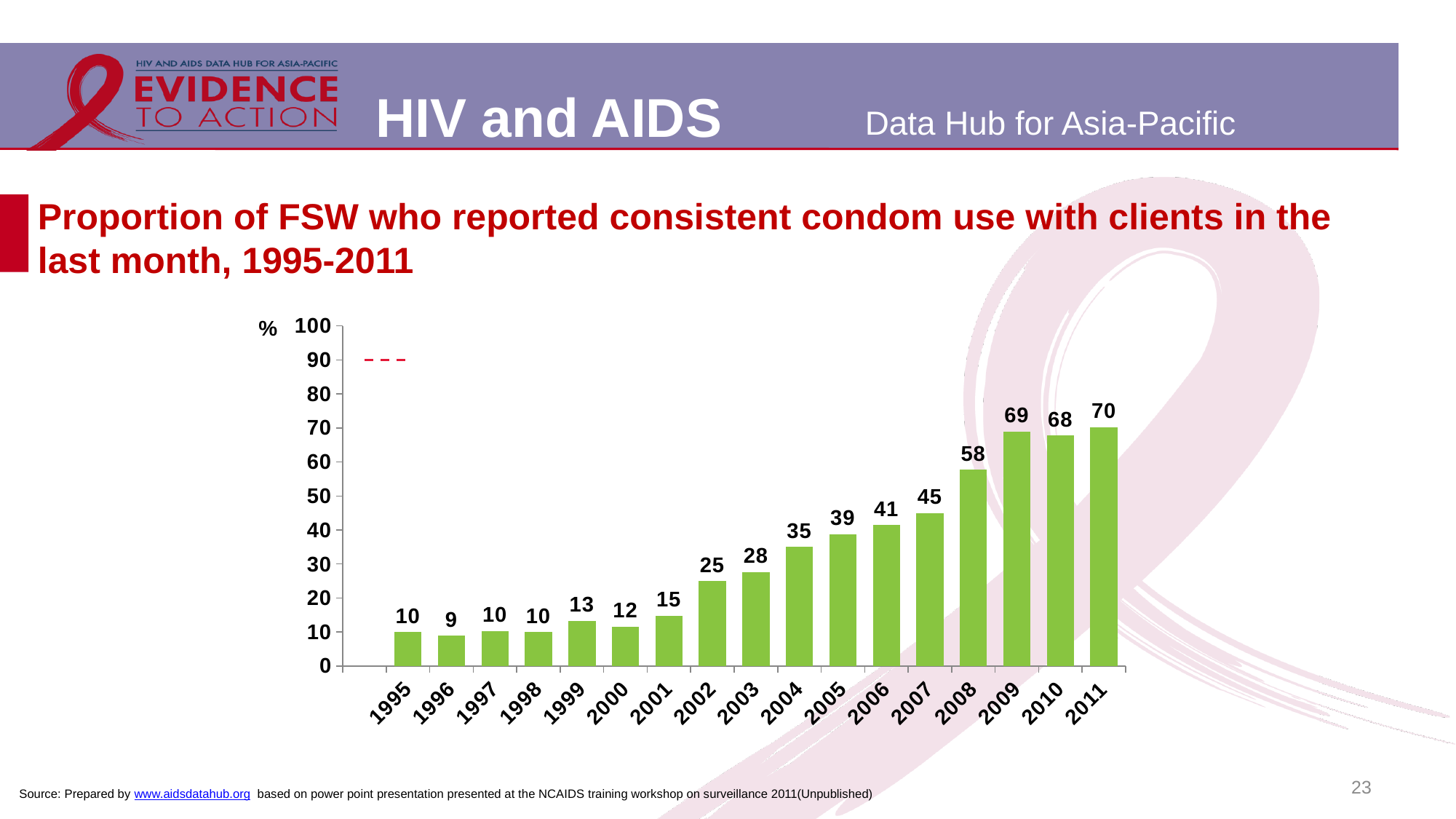
Which year has the lowest value? 1996 What kind of chart is shown on the slide? bar chart What is the value for 2004? 35 Do the values generally rise or fall from 1995 to 2011? rise Which is larger, the value for 2002 or the value for 2006? 2006 Which year has the highest value? 2011 What is the difference between the values for 2009 and 2008? 11 What is the difference between the values for 2011 and 1995? 60 What is the value for 1999? 13 Is the value for 2007 greater or less than 40? greater What is the value for 2008? 58 How many years are shown on the x axis? 17